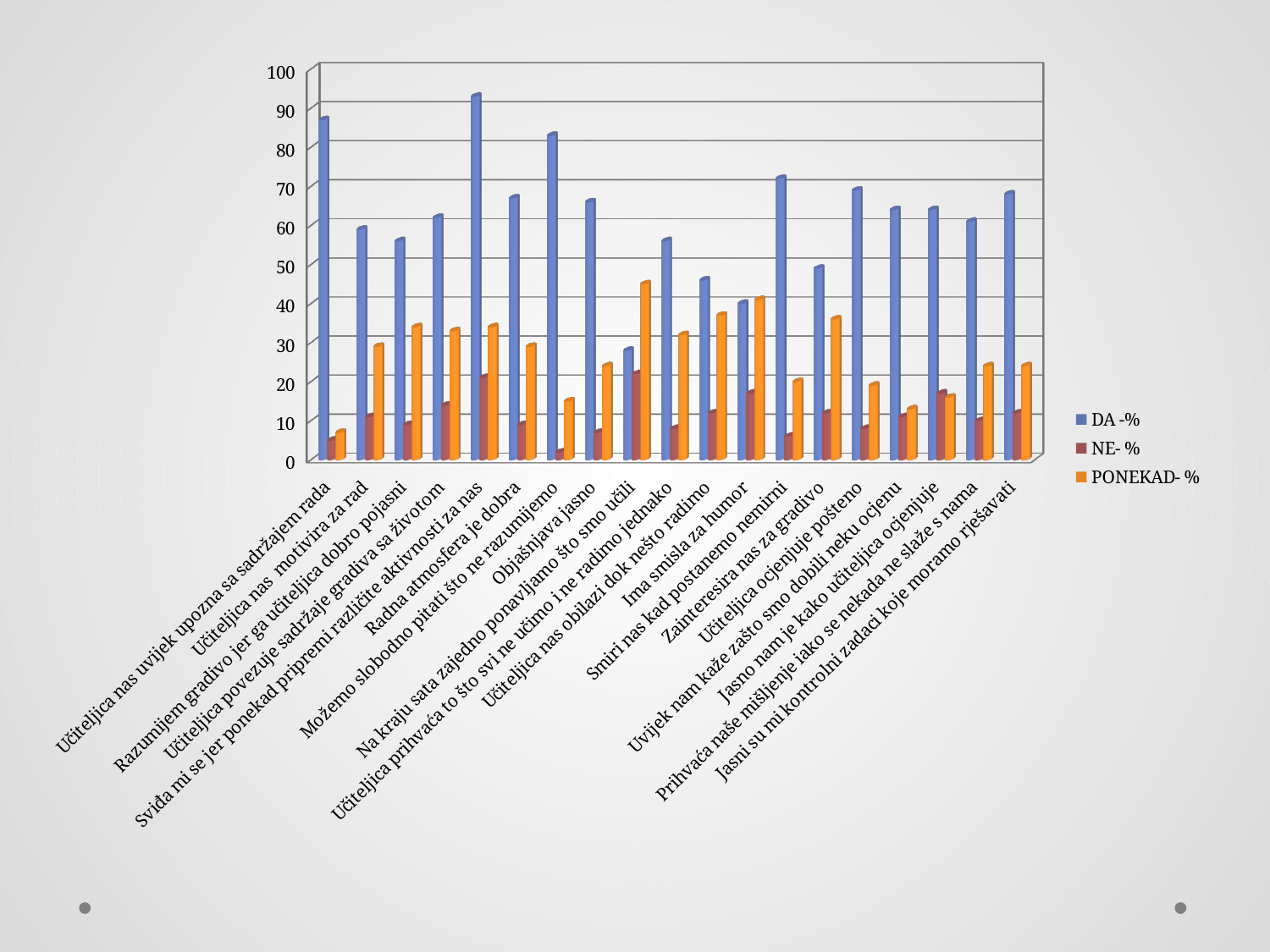
Is the DA -% value for 'Zainteresira nas za gradivo' greater or less than 60? less What kind of chart is shown on the slide? bar chart For 'Na kraju sata zajedno ponavljamo što smo učili', which is larger: the DA -% value or the PONEKAD- % value? PONEKAD- % Is the DA -% value for 'Možemo slobodno pitati što ne razumijemo' greater or less than 80? greater Is the PONEKAD- % value for 'Učiteljica ocjenjuje pošteno' greater or less than 30? less Which category has the lowest NE- % value? Možemo slobodno pitati što ne razumijemo How many categories are shown on the x axis? 19 Which series is shown in orange in the legend? PONEKAD- % Which category has the lowest DA -% value? Na kraju sata zajedno ponavljamo što smo učili How many series does the legend list? 3 Which category has the highest DA -% value? Sviđa mi se jer ponekad pripremi različite aktivnosti za nas